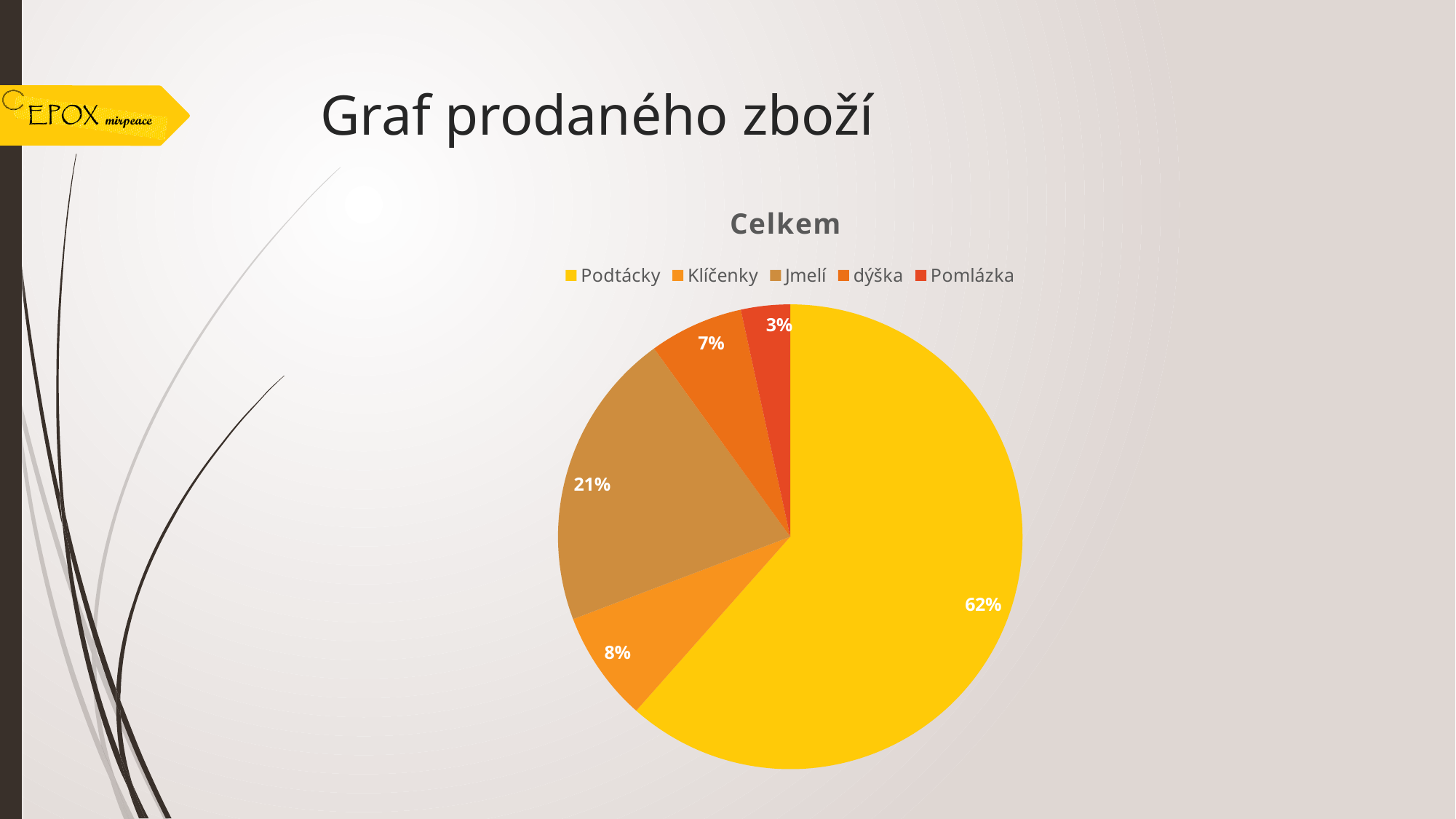
What share of the pie does Podtácky have? 62% How many categories does the pie chart show? 5 What kind of chart is shown on the slide? pie chart Which is larger, the share of Klíčenky or the share of dýška? Klíčenky What share of the pie does Klíčenky have? 8% What share of the pie does Pomlázka have? 3% What is the difference between the shares of Podtácky and Jmelí? 41% Which category has the smallest slice of the pie? Pomlázka Which category has the largest slice of the pie? Podtácky What is the title of the chart? Celkem